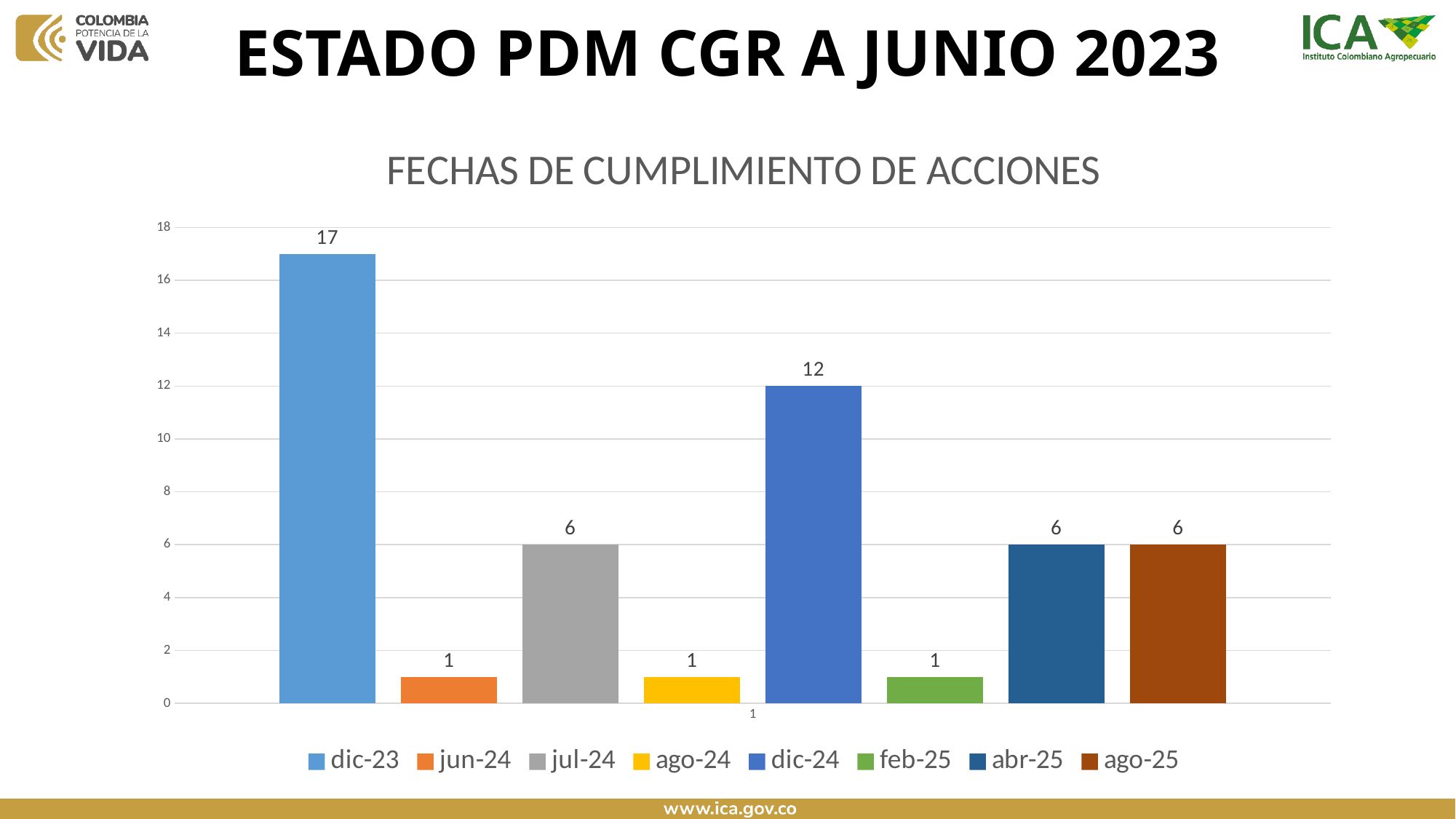
What is the title of the chart? FECHAS DE CUMPLIMIENTO DE ACCIONES What is the value for feb-25? 1 What is the difference between the values for abr-25 and jun-24? 5 What is the value for jul-24? 6 What is the value for dic-23? 17 What is the value for dic-24? 12 Which is larger, the value for dic-24 or the value for ago-25? dic-24 Which series has the highest value? dic-23 Is the value for dic-23 greater or less than 16? greater What is the difference between the values for dic-23 and dic-24? 5 What kind of chart is shown on the slide? bar chart How many series does the legend list? 8